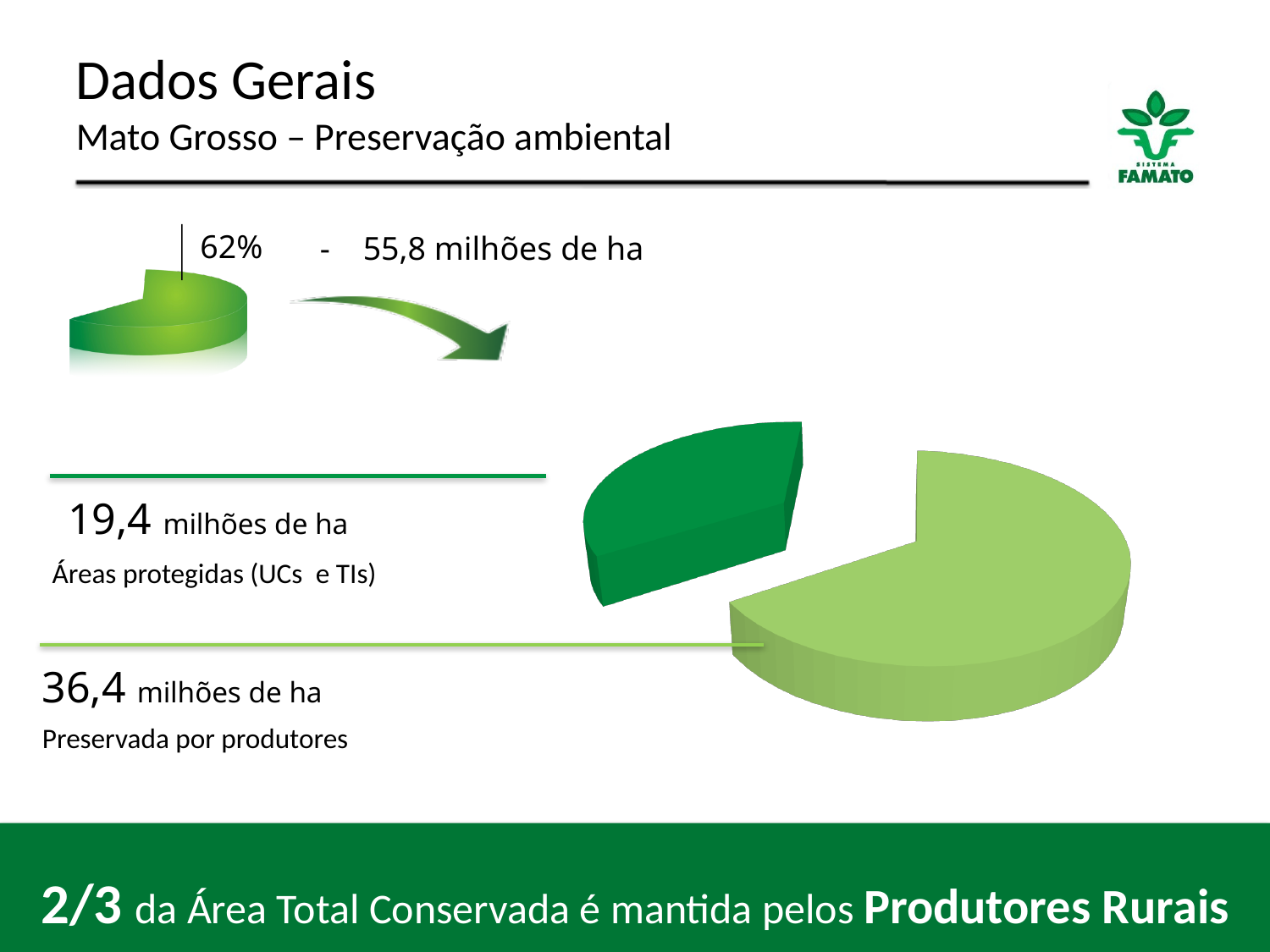
In the small pie chart at the top left, what area in hectares corresponds to the 62% slice? 55,8 milhões de ha In the large pie chart, what is the value for Áreas protegidas (UCs e TIs)? 19,4 milhões de ha In the large pie chart, what is the total of the two slices? 55,8 milhões de ha In the large pie chart, which category has the largest slice? Preservada por produtores In the large pie chart, which category has the smallest slice? Áreas protegidas (UCs e TIs) In the large pie chart, what is the value for Preservada por produtores? 36,4 milhões de ha In the small pie chart at the top left, what percentage is labelled on the highlighted slice? 62% What kind of chart is the large chart on the right side of the slide? pie chart In the large pie chart, what is the difference between Preservada por produtores and Áreas protegidas (UCs e TIs)? 17 milhões de ha In the large pie chart, how many slices are there? 2 According to the banner at the bottom of the slide, what fraction of the total conserved area is maintained by rural producers? 2/3 In the large pie chart, which is larger: Áreas protegidas (UCs e TIs) or Preservada por produtores? Preservada por produtores